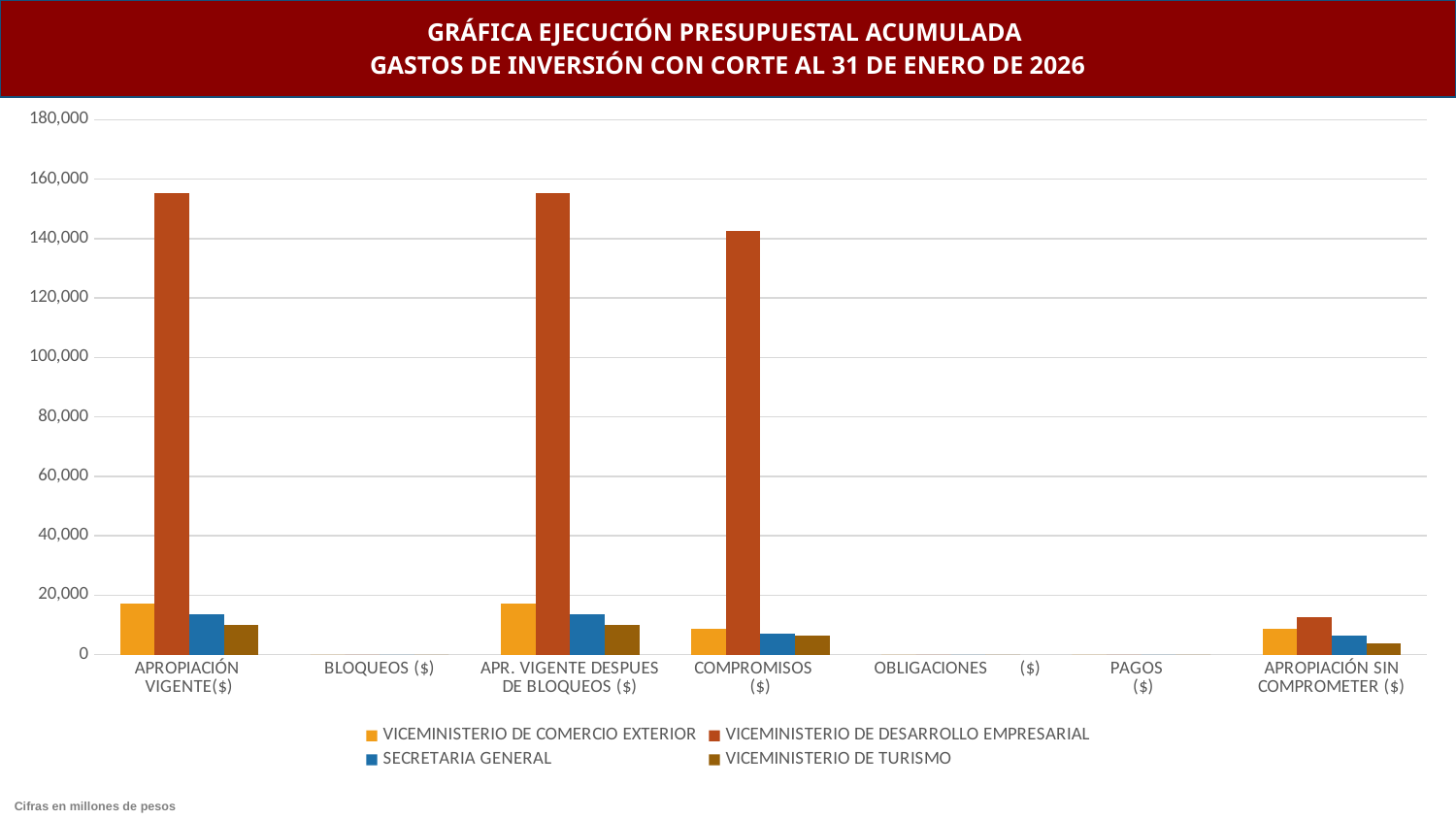
Which series has the lowest value in the APROPIACIÓN SIN COMPROMETER ($) category? VICEMINISTERIO DE TURISMO What kind of chart is shown on the slide? bar chart Is the value for VICEMINISTERIO DE DESARROLLO EMPRESARIAL in APROPIACIÓN VIGENTE($) greater or less than 140,000? greater Is the value for VICEMINISTERIO DE DESARROLLO EMPRESARIAL in COMPROMISOS ($) greater or less than 160,000? less In APROPIACIÓN VIGENTE($), which is larger: VICEMINISTERIO DE COMERCIO EXTERIOR or VICEMINISTERIO DE TURISMO? VICEMINISTERIO DE COMERCIO EXTERIOR How many categories are shown on the x axis? 7 Which series has the highest value in the COMPROMISOS ($) category? VICEMINISTERIO DE DESARROLLO EMPRESARIAL For VICEMINISTERIO DE DESARROLLO EMPRESARIAL, which is larger: APROPIACIÓN VIGENTE($) or COMPROMISOS ($)? APROPIACIÓN VIGENTE($) Is the value for VICEMINISTERIO DE COMERCIO EXTERIOR in APROPIACIÓN VIGENTE($) greater or less than 20,000? less What unit note is printed at the bottom left of the slide? Cifras en millones de pesos How many series does the legend list? 4